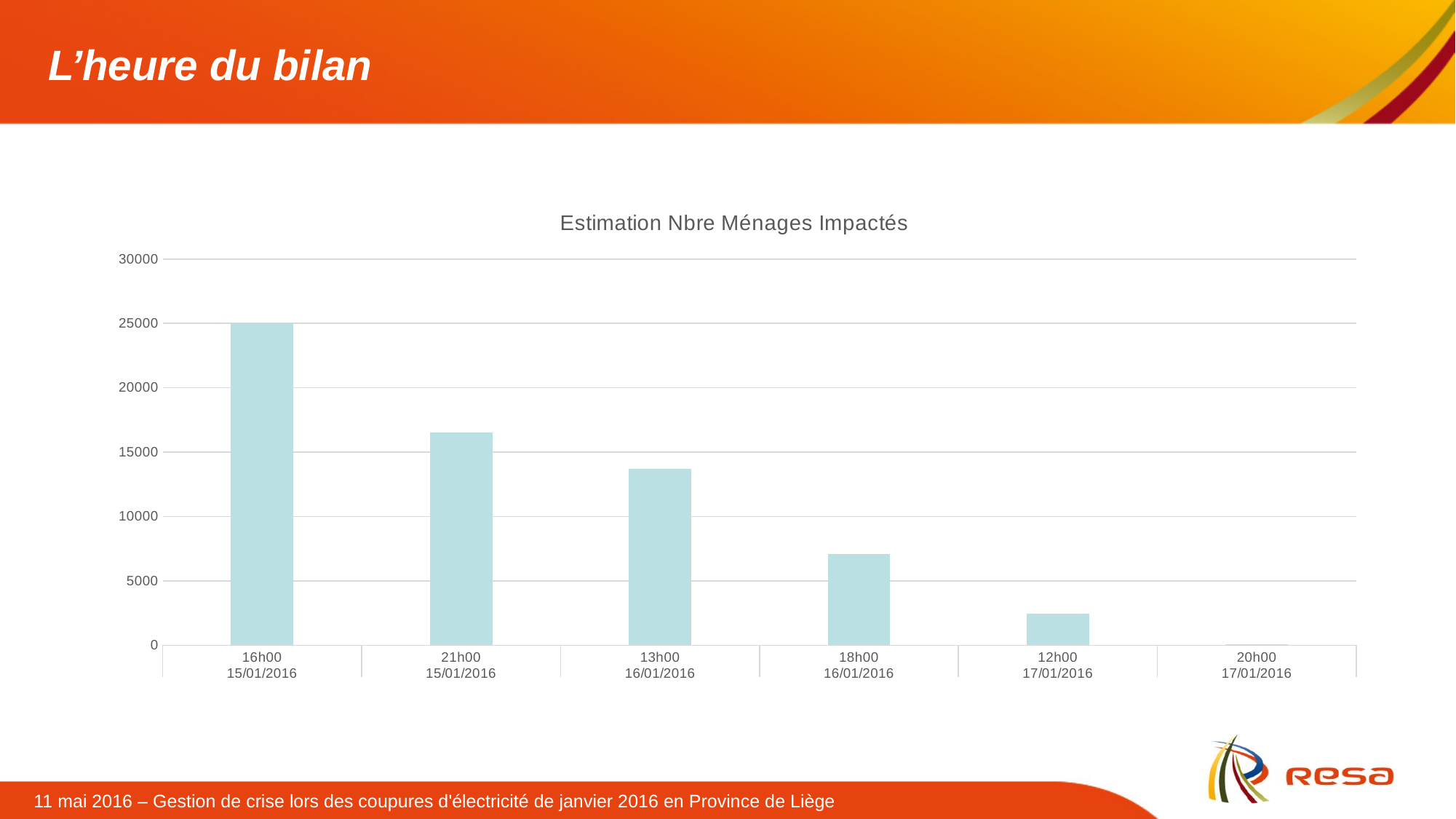
Is the value for 18h00 16/01/2016 greater or less than 5000? greater Is the value for 12h00 17/01/2016 greater or less than 5000? less Is the value for 13h00 16/01/2016 greater or less than 15000? less Which time point has the highest estimated number of households impacted? 16h00 15/01/2016 Do the values rise or fall from left to right along the x axis? fall What is the title of the chart? Estimation Nbre Ménages Impactés How many bars (time points) does the chart show? 6 Which time point has the lowest estimated number of households impacted? 20h00 17/01/2016 What kind of chart is shown on the slide? bar chart What is the estimated number of households impacted at 16h00 15/01/2016? 25000 Which is larger, the value for 21h00 15/01/2016 or the value for 13h00 16/01/2016? 21h00 15/01/2016